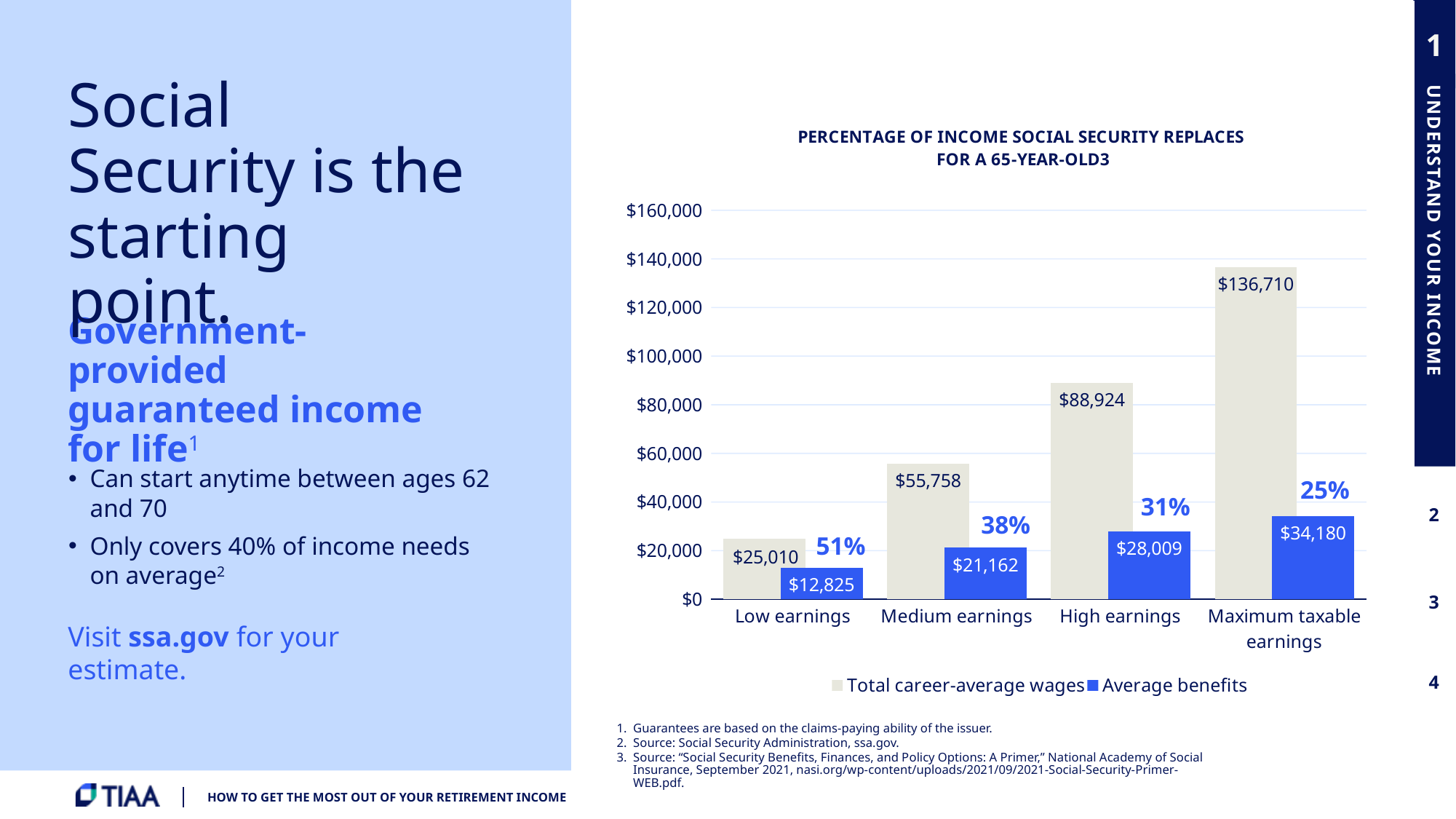
Do the replacement percentages rise or fall as earnings increase from Low earnings to Maximum taxable earnings? Fall How many earnings categories are shown on the x axis? 4 Which category has the highest total career-average wages? Maximum taxable earnings What percentage of income does Social Security replace for the Low earnings category? 51% Which category has the lowest average benefits? Low earnings What is the average benefit for the Medium earnings category? $21,162 Which is larger: the average benefit for High earnings or the average benefit for Medium earnings? High earnings What is the total career-average wage for the High earnings category? $88,924 What is the difference between total career-average wages and average benefits for the Maximum taxable earnings category? $102,530 Is the total career-average wage for Medium earnings greater or less than $60,000? less How many series does the legend list? 2 What kind of chart is shown on the slide? Bar chart